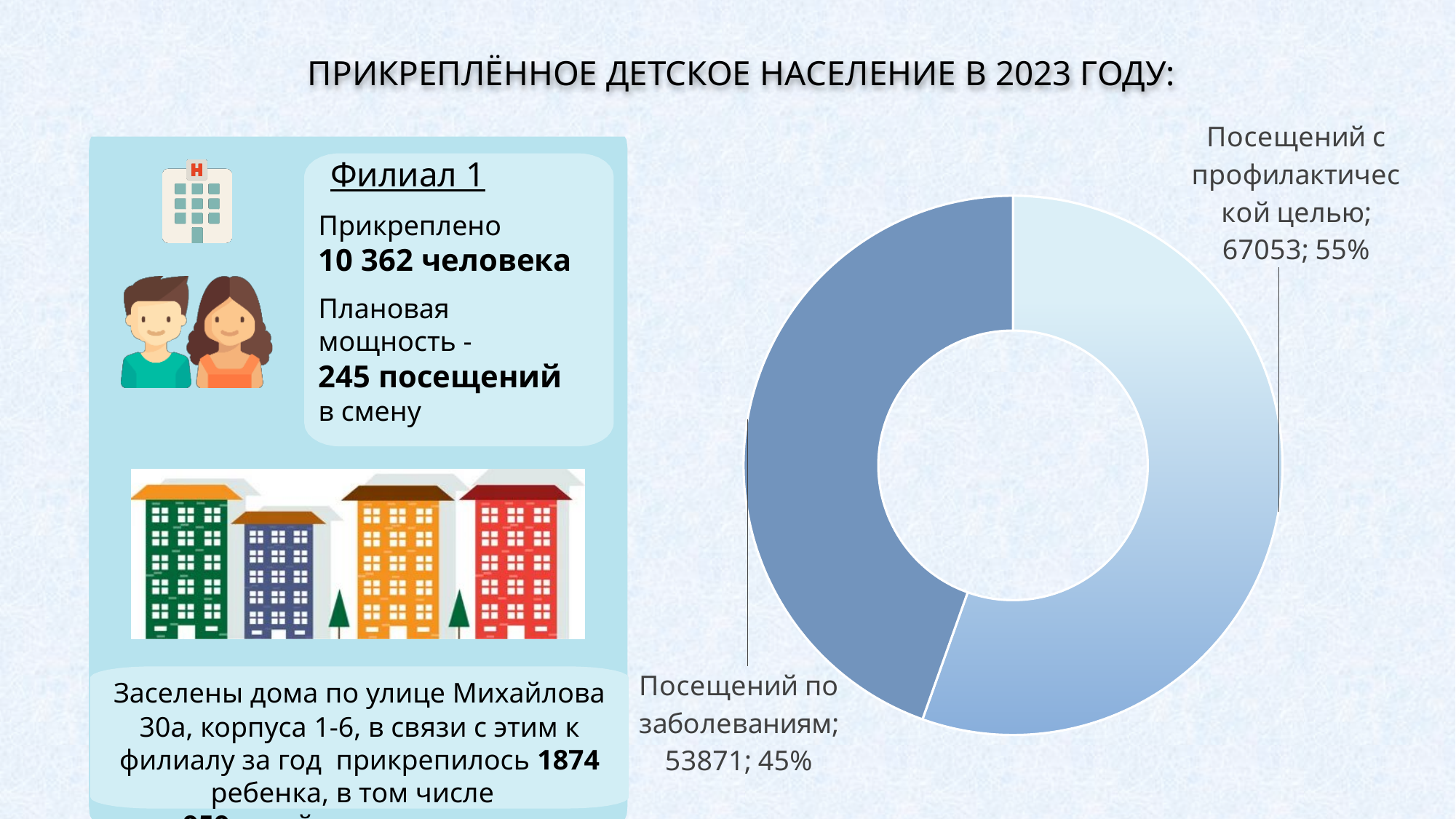
What share of the doughnut chart does "Посещений с профилактической целью" represent? 55% How many slices does the doughnut chart have? 2 What share of the doughnut chart does "Посещений по заболеваниям" represent? 45% Which slice of the doughnut chart is the largest? Посещений с профилактической целью What is the value for "Посещений с профилактической целью" in the doughnut chart? 67053 Which slice of the doughnut chart is the smallest? Посещений по заболеваниям What kind of chart is shown on the right side of the slide? Doughnut chart Which is larger in the doughnut chart: "Посещений по заболеваниям" or "Посещений с профилактической целью"? Посещений с профилактической целью What is the total of the two values shown in the doughnut chart? 120924 Which slice of the doughnut chart is drawn in the darker blue colour? Посещений по заболеваниям What is the difference between the values for "Посещений с профилактической целью" and "Посещений по заболеваниям" in the doughnut chart? 13182 What is the value for "Посещений по заболеваниям" in the doughnut chart? 53871